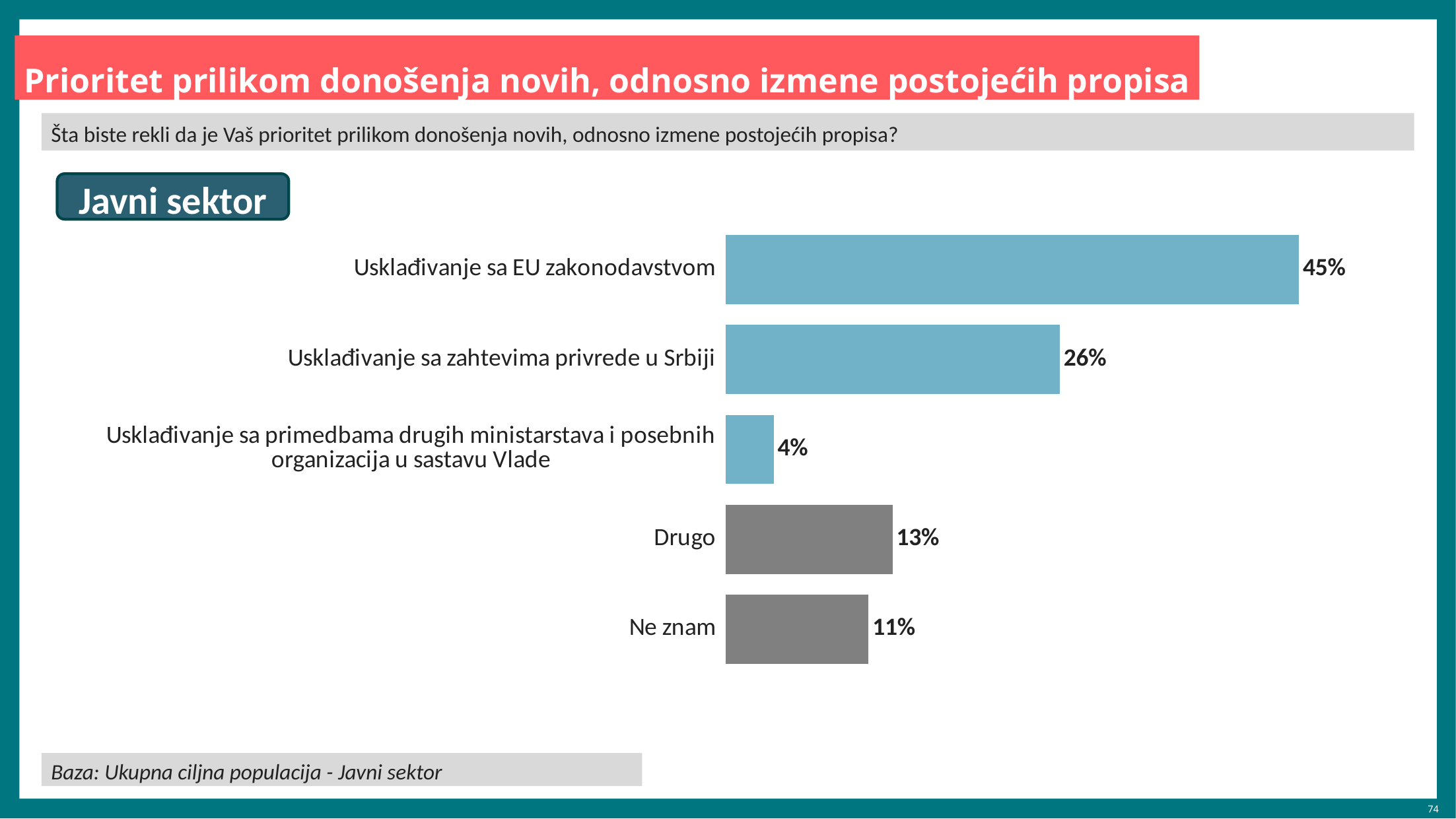
Which category has the lowest value? Usklađivanje sa primedbama drugih ministarstava i posebnih organizacija u sastavu Vlade What kind of chart is shown on the slide? Bar chart Which is larger, the value for Drugo or the value for Ne znam? Drugo What is the difference between the values for Usklađivanje sa EU zakonodavstvom and Usklađivanje sa zahtevima privrede u Srbiji? 19% How many categories are shown in the chart? 5 Which category has the highest value? Usklađivanje sa EU zakonodavstvom What is the value for Usklađivanje sa primedbama drugih ministarstava i posebnih organizacija u sastavu Vlade? 4% Which group does the chart refer to, according to the label above it? Javni sektor What is the value for Ne znam? 11% What is the value for Usklađivanje sa zahtevima privrede u Srbiji? 26% What is the value for Drugo? 13% What is the value for Usklađivanje sa EU zakonodavstvom? 45%